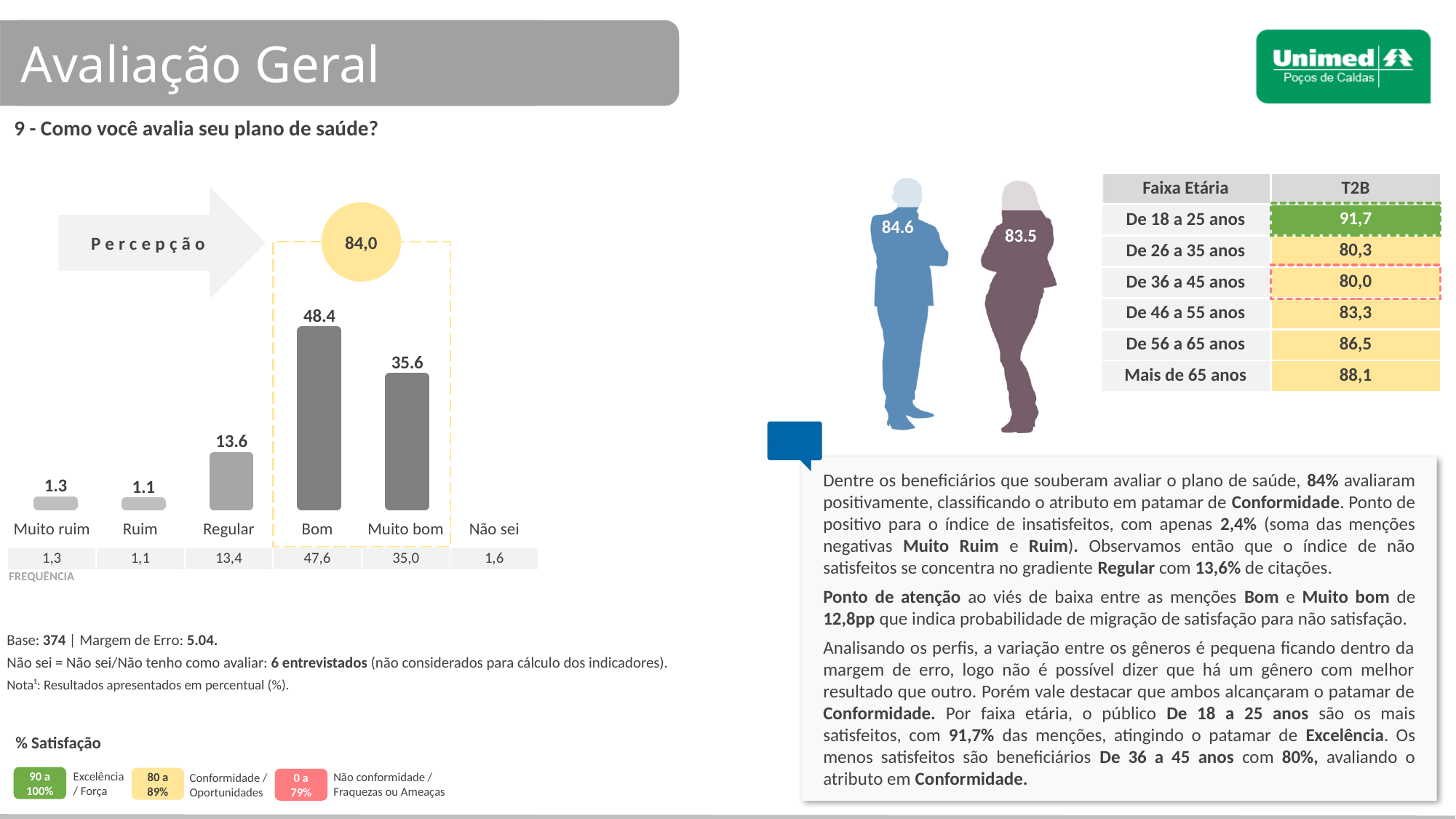
What value is shown in the yellow circle above the highlighted Bom and Muito bom bars? 84,0 What is the value shown for Regular? 13.6 Which category has the lowest value among the plotted bars? Ruim What is the value shown for Bom? 48.4 Which category has the highest value? Bom What kind of chart is shown on the slide? bar chart What is the value shown for Ruim? 1.1 How many bars are plotted in the chart? 5 What is the value shown for Muito ruim? 1.3 What is the difference between the values for Bom and Muito bom? 12.8 Which is larger, the value for Regular or the value for Muito bom? Muito bom What is the value shown for Muito bom? 35.6